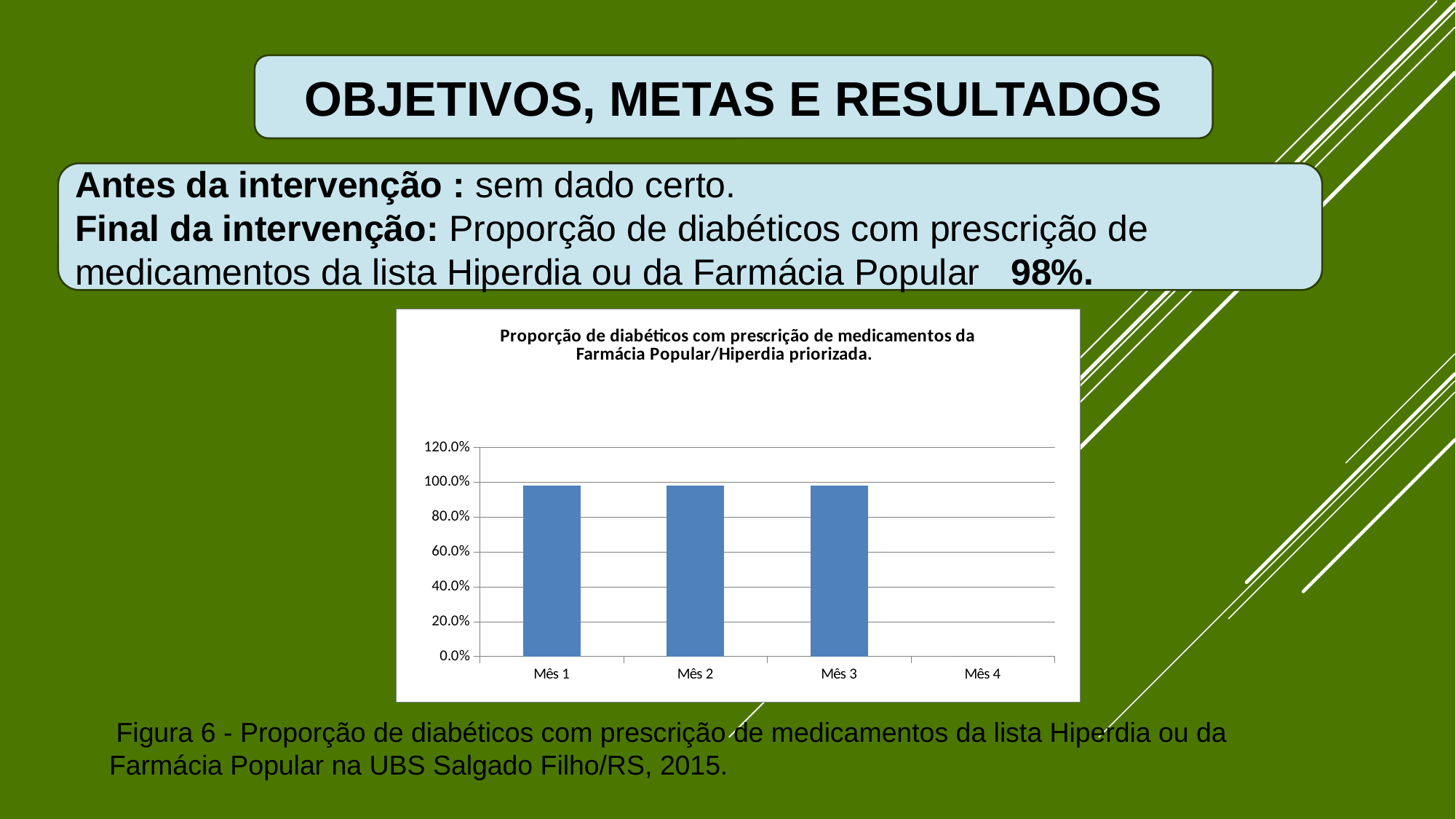
Which category has no bar plotted in the chart? Mês 4 Is the value for Mês 2 greater or less than 60.0%? greater What is the label of the first category on the x axis? Mês 1 Which category has the lowest value in the chart? Mês 4 How many categories are shown on the x axis of the chart? 4 Is the value for Mês 1 greater or less than 80.0%? greater Do the values rise, fall or stay roughly the same from Mês 1 to Mês 3? stay roughly the same Is the value for Mês 3 greater or less than 40.0%? greater What kind of chart is shown on the slide? bar chart What is the highest tick value shown on the y axis of the chart? 120.0% Is the value for Mês 1 larger than the value for Mês 4? Yes